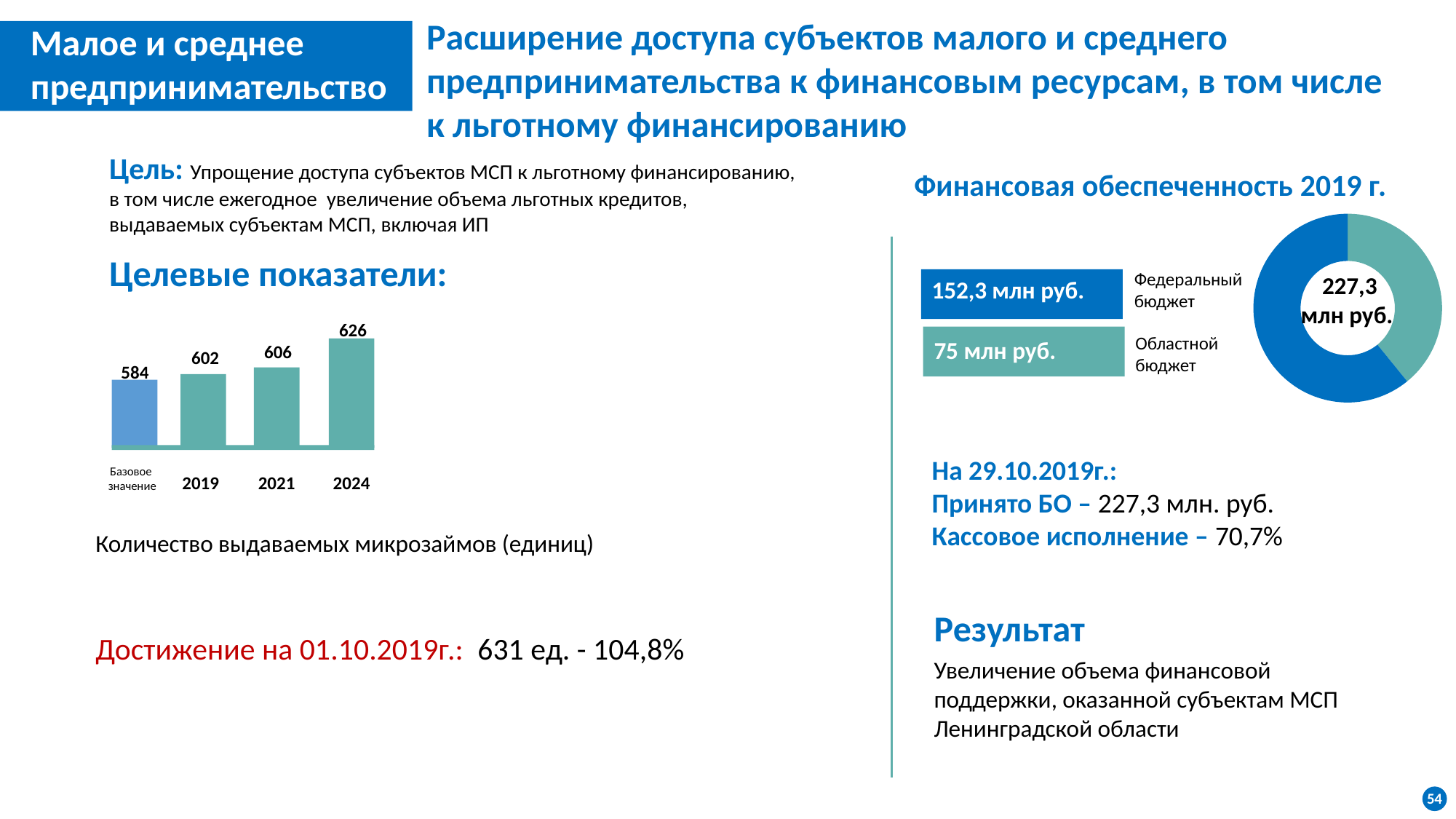
In the donut chart titled Финансовая обеспеченность 2019 г., which is larger: Федеральный бюджет or Областной бюджет? Федеральный бюджет In the bar chart on the left, which category has the lowest value? Базовое значение In the bar chart on the left, what is the difference between the values for 2024 and 2019? 24 In the bar chart on the left, what is the value for Базовое значение? 584 In the donut chart titled Финансовая обеспеченность 2019 г., what total is shown in the centre? 227,3 млн руб. In the donut chart titled Финансовая обеспеченность 2019 г., what is the value for Федеральный бюджет? 152,3 млн руб. In the bar chart on the left, how many bars are shown? 4 In the bar chart on the left, do the values rise or fall from Базовое значение to 2024? rise In the bar chart on the left, what is the value for 2021? 606 What kind of chart is shown under the heading Целевые показатели? bar chart In the bar chart on the left, which category has the highest value? 2024 In the bar chart on the left (Количество выдаваемых микрозаймов), what is the value for 2024? 626